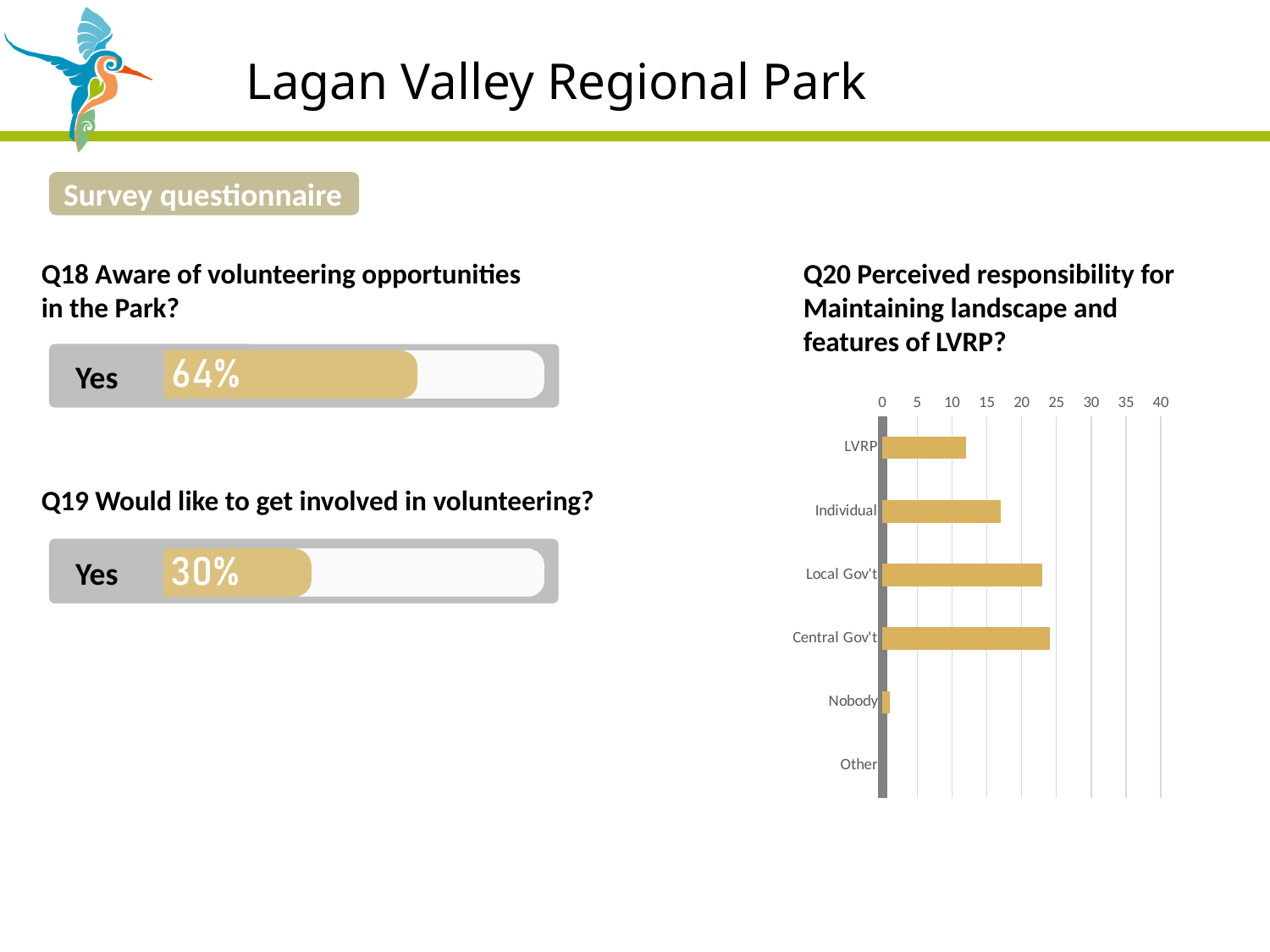
What kind of chart is used for Q20 Perceived responsibility for Maintaining landscape and features of LVRP? Bar chart In the Q20 chart, which is larger, Individual or LVRP? Individual In the Q20 chart, is the value for LVRP greater or less than 15? less In the Q20 chart, is the value for Individual greater or less than 20? less What percentage answered Yes to Q19 Would like to get involved in volunteering? 30% In the Q20 chart, which category has the lowest value? Other How many categories are shown in the Q20 chart? 6 What percentage answered Yes to Q18 Aware of volunteering opportunities in the Park? 64% In the Q20 chart, which is larger, Local Gov't or LVRP? Local Gov't In the Q20 chart, is the value for Nobody greater or less than 5? less